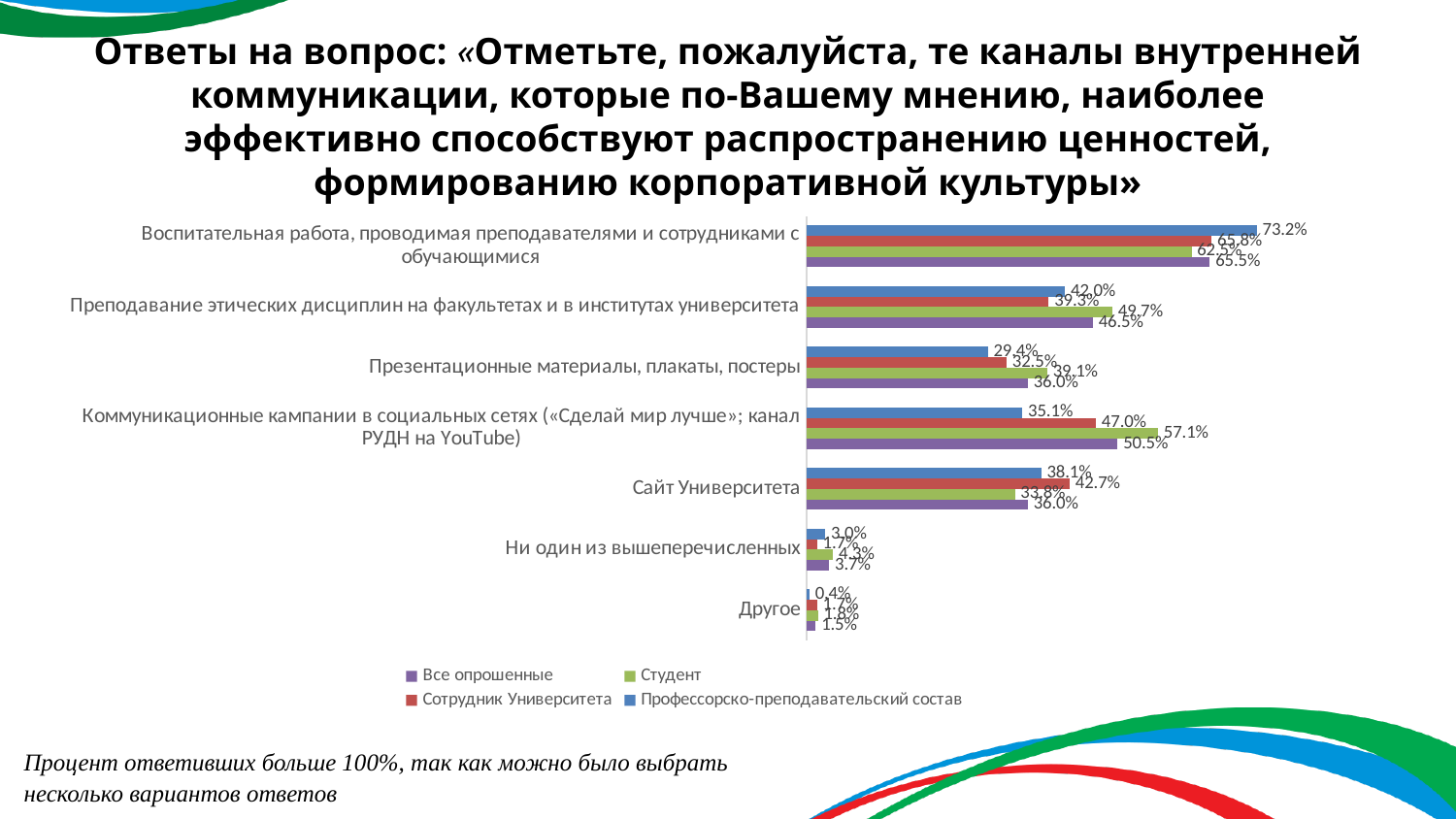
What is the value for «Студент» for «Коммуникационные кампании в социальных сетях»? 57.1% What is the value for «Сотрудник Университета» for «Сайт Университета»? 42.7% What is the value for «Все опрошенные» for «Преподавание этических дисциплин на факультетах и в институтах университета»? 46.5% Which category has the highest value for «Профессорско-преподавательский состав»? Воспитательная работа, проводимая преподавателями и сотрудниками с обучающимися What is the value for «Профессорско-преподавательский состав» for «Воспитательная работа, проводимая преподавателями и сотрудниками с обучающимися»? 73.2% How many series does the legend list? 4 Which category has the lowest value for «Профессорско-преподавательский состав»? Другое Which colour represents the «Студент» series in the legend? Green For «Коммуникационные кампании в социальных сетях», what is the difference between the «Студент» value and the «Профессорско-преподавательский состав» value? 22.0 percentage points How many categories (communication channels) are plotted on the chart? 7 What kind of chart is shown on the slide? Bar chart For «Преподавание этических дисциплин», which is larger: the «Студент» value or the «Сотрудник Университета» value? Студент